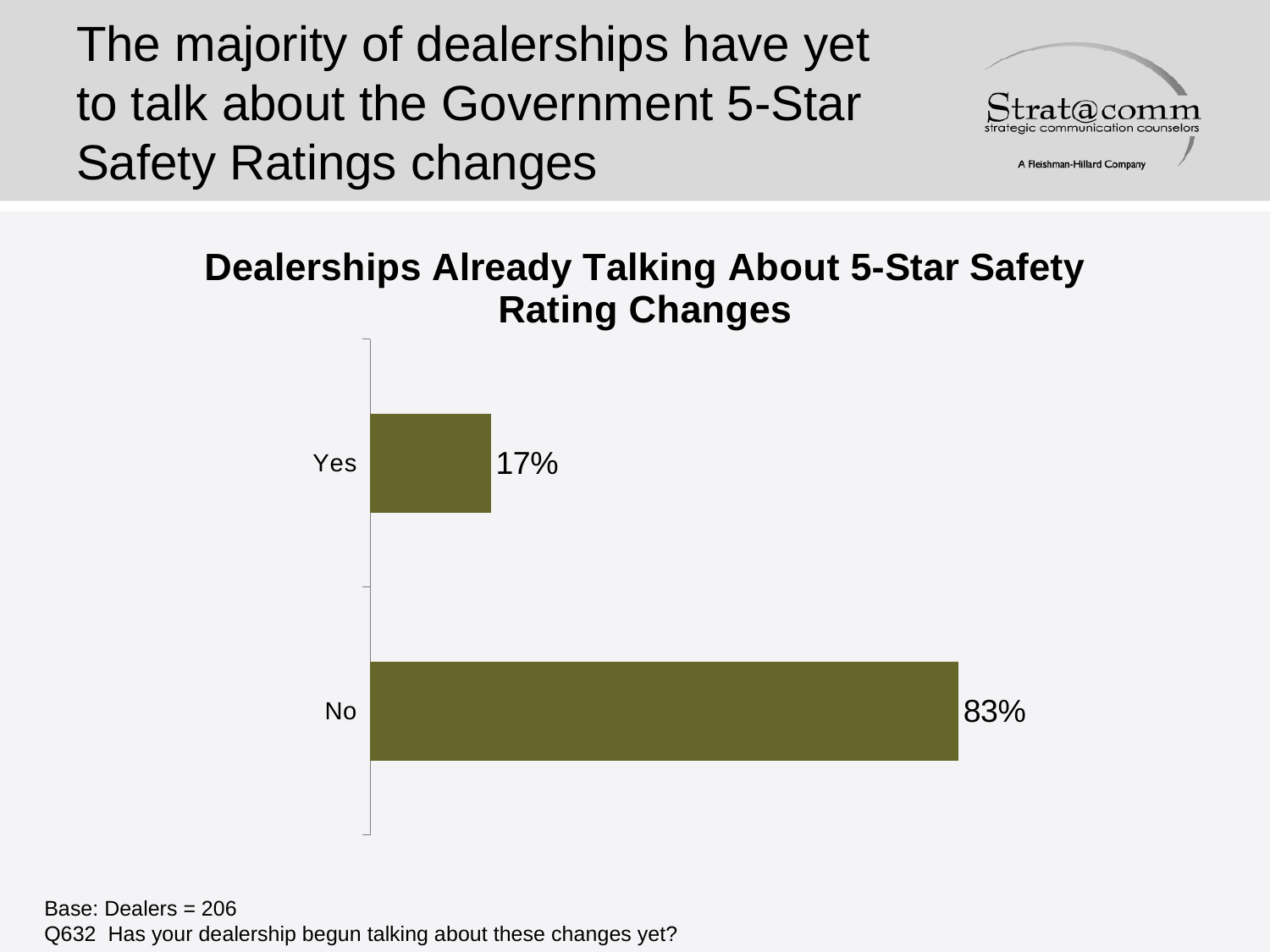
What percentage of dealerships answered "Yes" to already talking about the 5-Star Safety Rating changes? 17% Which category has the lowest value in the chart? Yes What is the difference in percentage points between the "No" and "Yes" responses? 66 What percentage of dealerships answered "No"? 83% How many dealers make up the base for this chart? 206 What is the total of the "Yes" and "No" percentages? 100% How many categories are shown in the chart? 2 What is the title of the chart? Dealerships Already Talking About 5-Star Safety Rating Changes Which category has the highest value in the chart? No Which is larger, the value for "Yes" or the value for "No"? No What kind of chart is shown on the slide? Bar chart